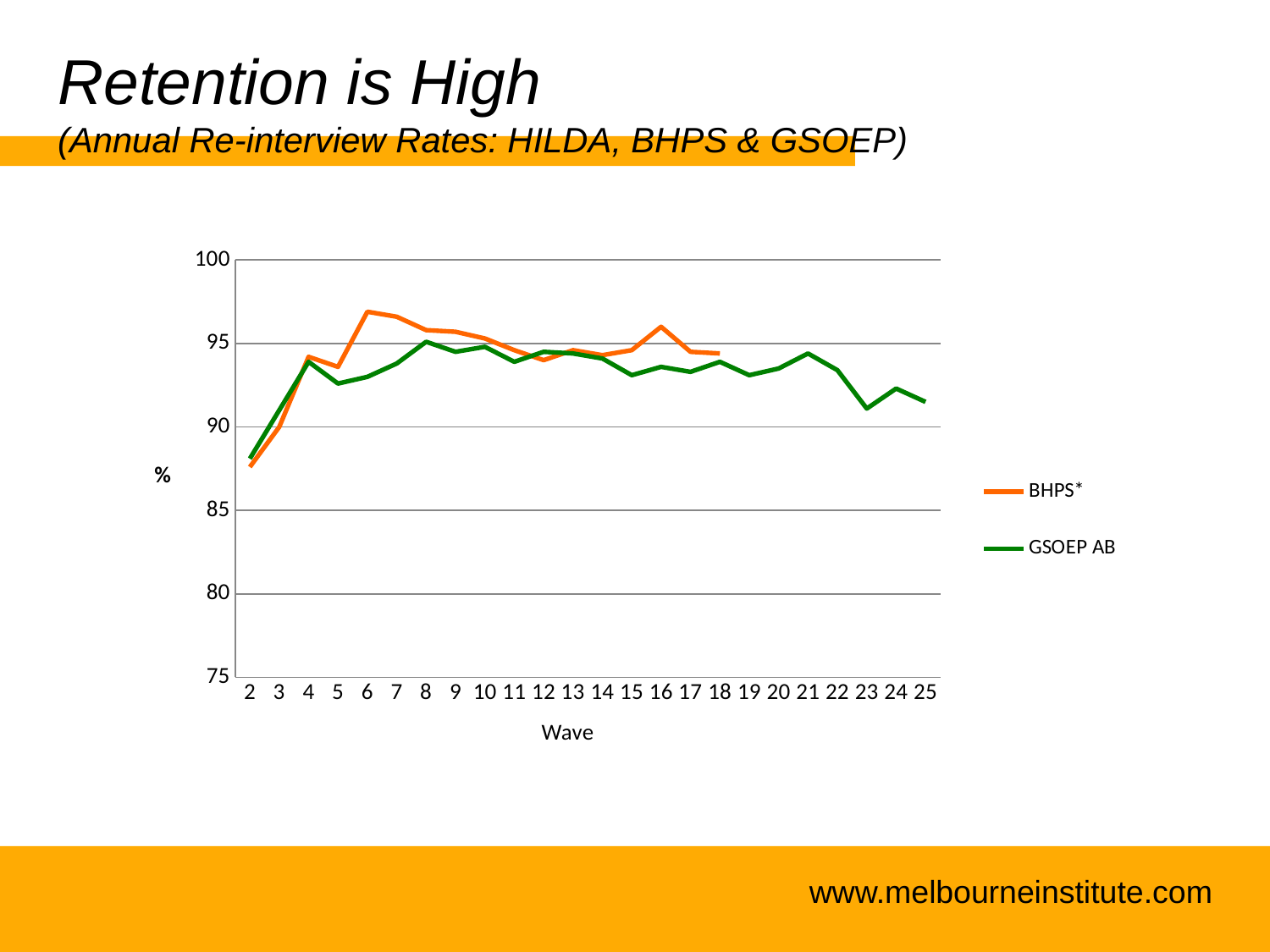
Is the GSOEP AB value at wave 2 greater or less than 90? less At which wave is the BHPS* series at its lowest? Wave 2 At wave 6, which series has the higher value, BHPS* or GSOEP AB? BHPS* Is the BHPS* value at wave 2 greater or less than 90? less What are the two series named in the legend? BHPS* and GSOEP AB Is the GSOEP AB value at wave 25 greater or less than 95? less How many waves are labelled along the x axis? 24 Does the GSOEP AB series rise or fall from wave 21 to wave 23? Fall What kind of chart is shown on the slide? Line chart How many series does the legend list? 2 At which wave is the GSOEP AB series at its lowest? Wave 2